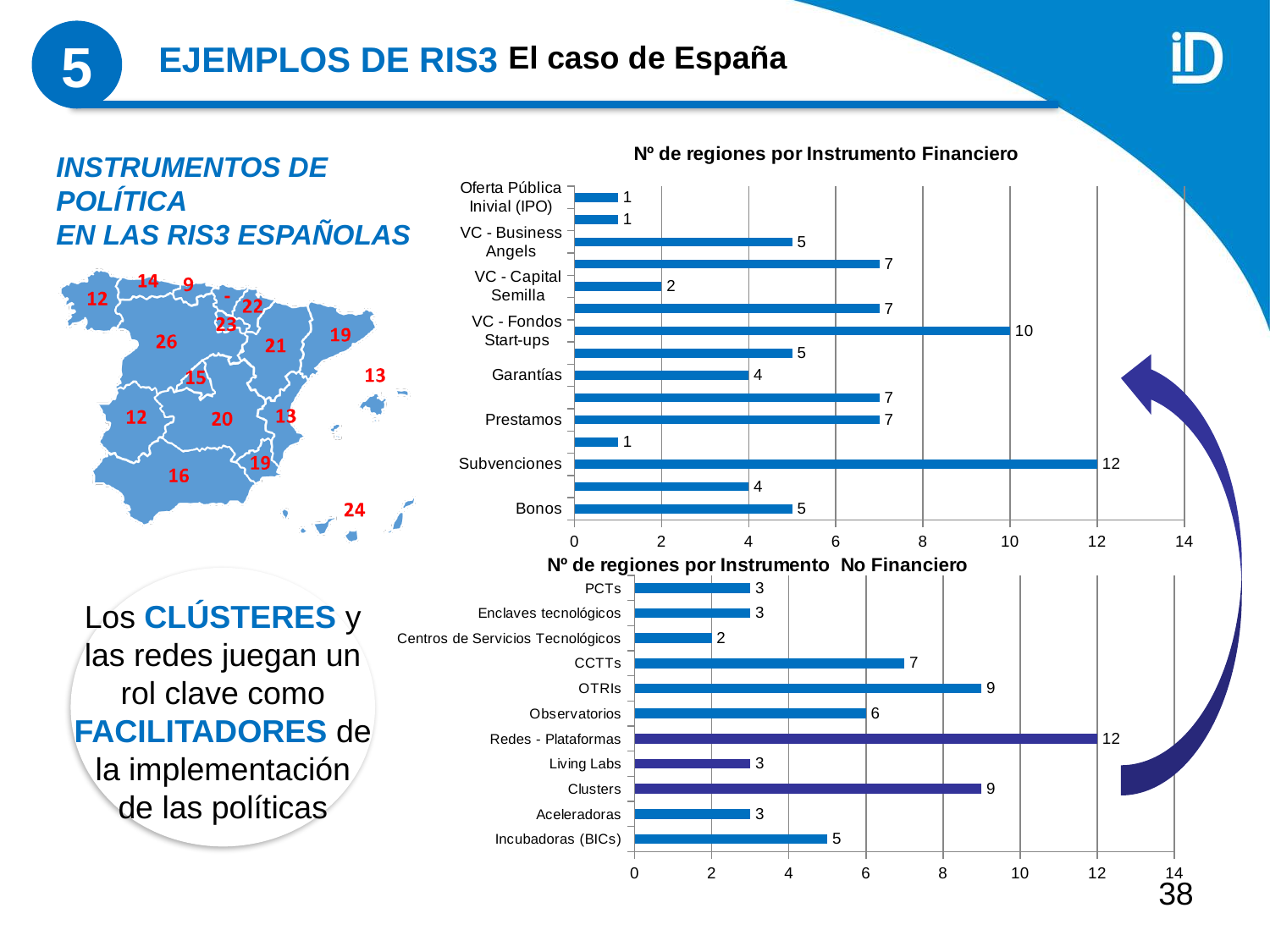
In the chart 'Nº de regiones por Instrumento Financiero', which is larger, Prestamos or Bonos? Prestamos In the chart 'Nº de regiones por Instrumento No Financiero', which category has the lowest value? Centros de Servicios Tecnológicos In the chart 'Nº de regiones por Instrumento No Financiero', what is the value for Redes - Plataformas? 12 In the chart 'Nº de regiones por Instrumento Financiero', what is the value for Garantías? 4 In the chart 'Nº de regiones por Instrumento Financiero', what is the value for Subvenciones? 12 In the chart 'Nº de regiones por Instrumento No Financiero', what is the difference between the values for Clusters and Living Labs? 6 In the chart 'Nº de regiones por Instrumento No Financiero', what is the value for Incubadoras (BICs)? 5 How many categories are shown in the chart 'Nº de regiones por Instrumento No Financiero'? 11 What kind of chart is 'Nº de regiones por Instrumento Financiero'? Bar chart In the chart 'Nº de regiones por Instrumento No Financiero', what is the value for OTRIs? 9 In the chart 'Nº de regiones por Instrumento No Financiero', which is larger, CCTTs or Observatorios? CCTTs In the chart 'Nº de regiones por Instrumento No Financiero', which category has the highest value? Redes - Plataformas